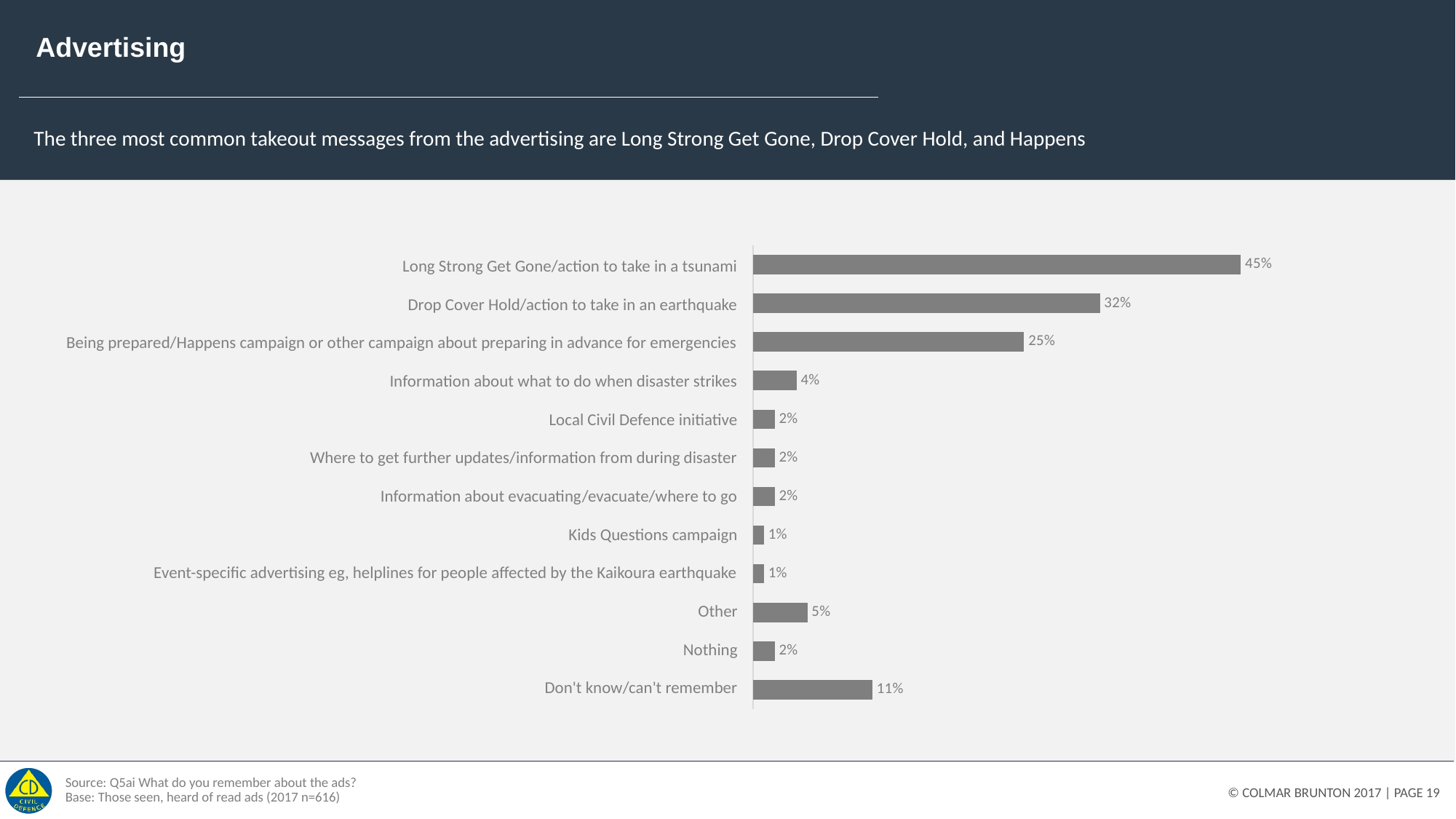
Which is larger: the value for Other or the value for Information about what to do when disaster strikes? Other How many categories are shown in the chart? 12 What percentage is shown for Long Strong Get Gone/action to take in a tsunami? 45% Which category has the highest value? Long Strong Get Gone/action to take in a tsunami What percentage is shown for Drop Cover Hold/action to take in an earthquake? 32% What is the difference between the values for Being prepared/Happens campaign or other campaign about preparing in advance for emergencies and Don't know/can't remember? 14% What percentage is shown for Kids Questions campaign? 1% Which is larger: the value for Don't know/can't remember or the value for Being prepared/Happens campaign or other campaign about preparing in advance for emergencies? Being prepared/Happens campaign or other campaign about preparing in advance for emergencies What percentage is shown for Don't know/can't remember? 11% What is the difference between the values for Long Strong Get Gone/action to take in a tsunami and Drop Cover Hold/action to take in an earthquake? 13% What kind of chart is shown on the slide? Bar chart What percentage is shown for Other? 5%